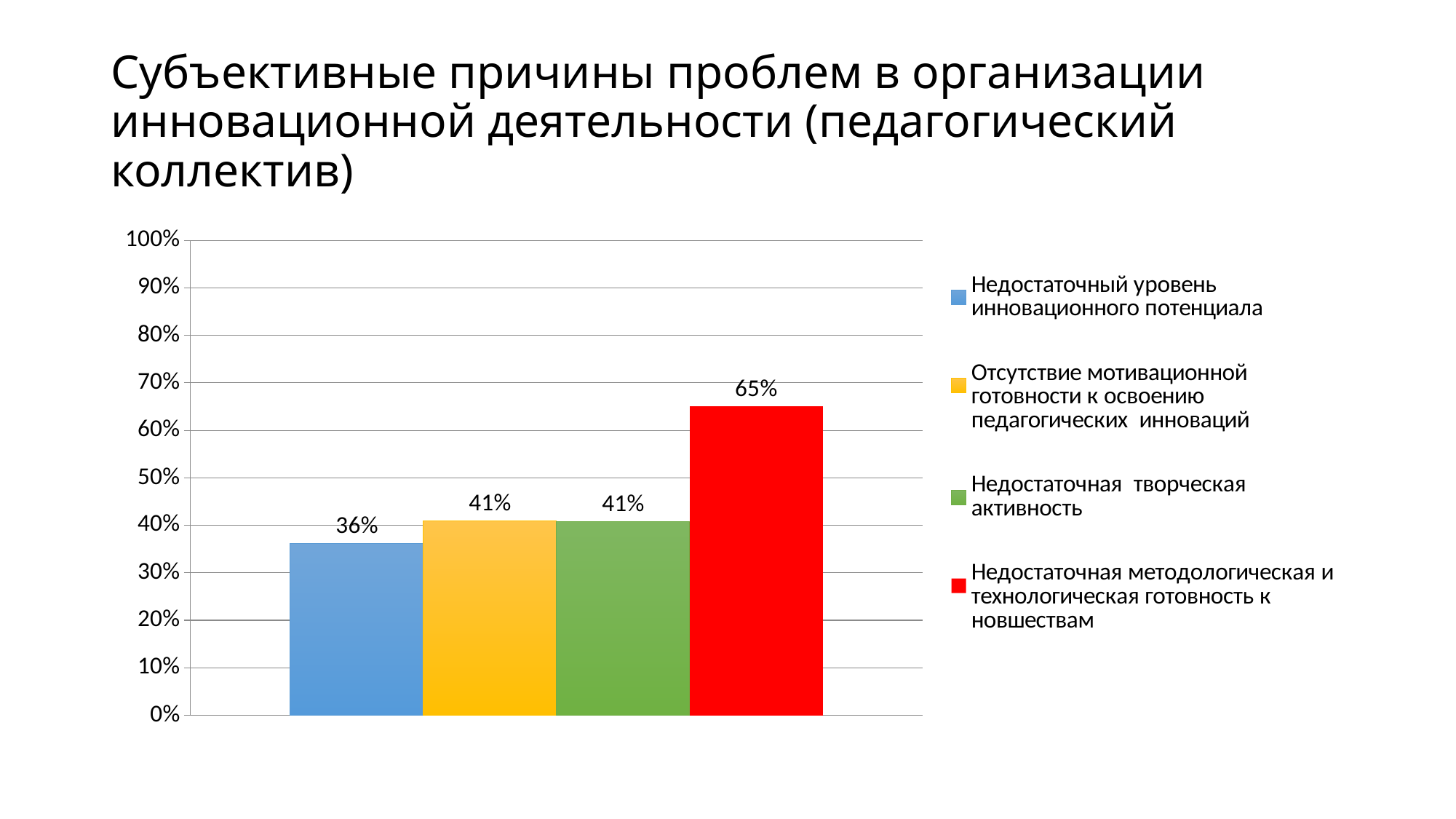
What kind of chart is shown on the slide? bar chart What is the value for «Недостаточная творческая активность»? 41% Which is larger: the value for «Недостаточная творческая активность» or the value for «Недостаточный уровень инновационного потенциала»? Недостаточная творческая активность What is the value for «Недостаточная методологическая и технологическая готовность к новшествам»? 65% Which category has the lowest value? Недостаточный уровень инновационного потенциала How many entries does the legend list? 4 Is the value for «Недостаточная методологическая и технологическая готовность к новшествам» greater or less than 60%? greater How many bars are plotted on the chart? 4 What is the difference between the values for «Недостаточная методологическая и технологическая готовность к новшествам» and «Недостаточный уровень инновационного потенциала»? 29% What is the value for «Отсутствие мотивационной готовности к освоению педагогических инноваций»? 41% What is the value for «Недостаточный уровень инновационного потенциала»? 36% Which category has the highest value? Недостаточная методологическая и технологическая готовность к новшествам